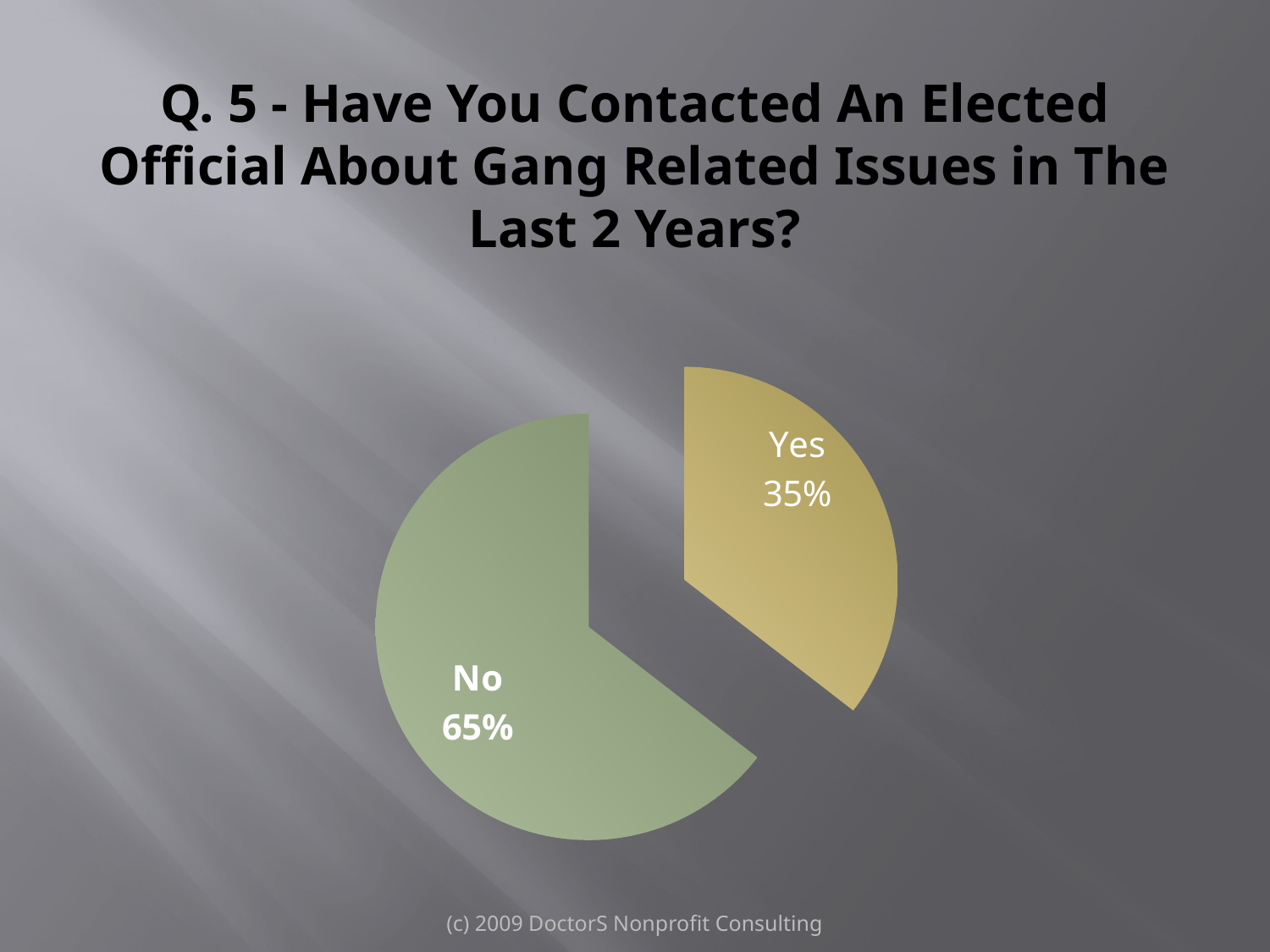
Which response has the largest share of the pie? No What share of the pie does the Yes slice represent? 35% Which slice of the pie is shown in green? No What percentage of respondents answered No? 65% Which response has the smallest share of the pie? Yes Which is larger, the share for Yes or the share for No? No What is the difference in percentage points between the No and Yes responses? 30 What kind of chart is shown on the slide? pie chart How many slices does the pie chart have? 2 What percentage of respondents answered Yes? 35% What is the title of the chart on the slide? Q. 5 - Have You Contacted An Elected Official About Gang Related Issues in The Last 2 Years?